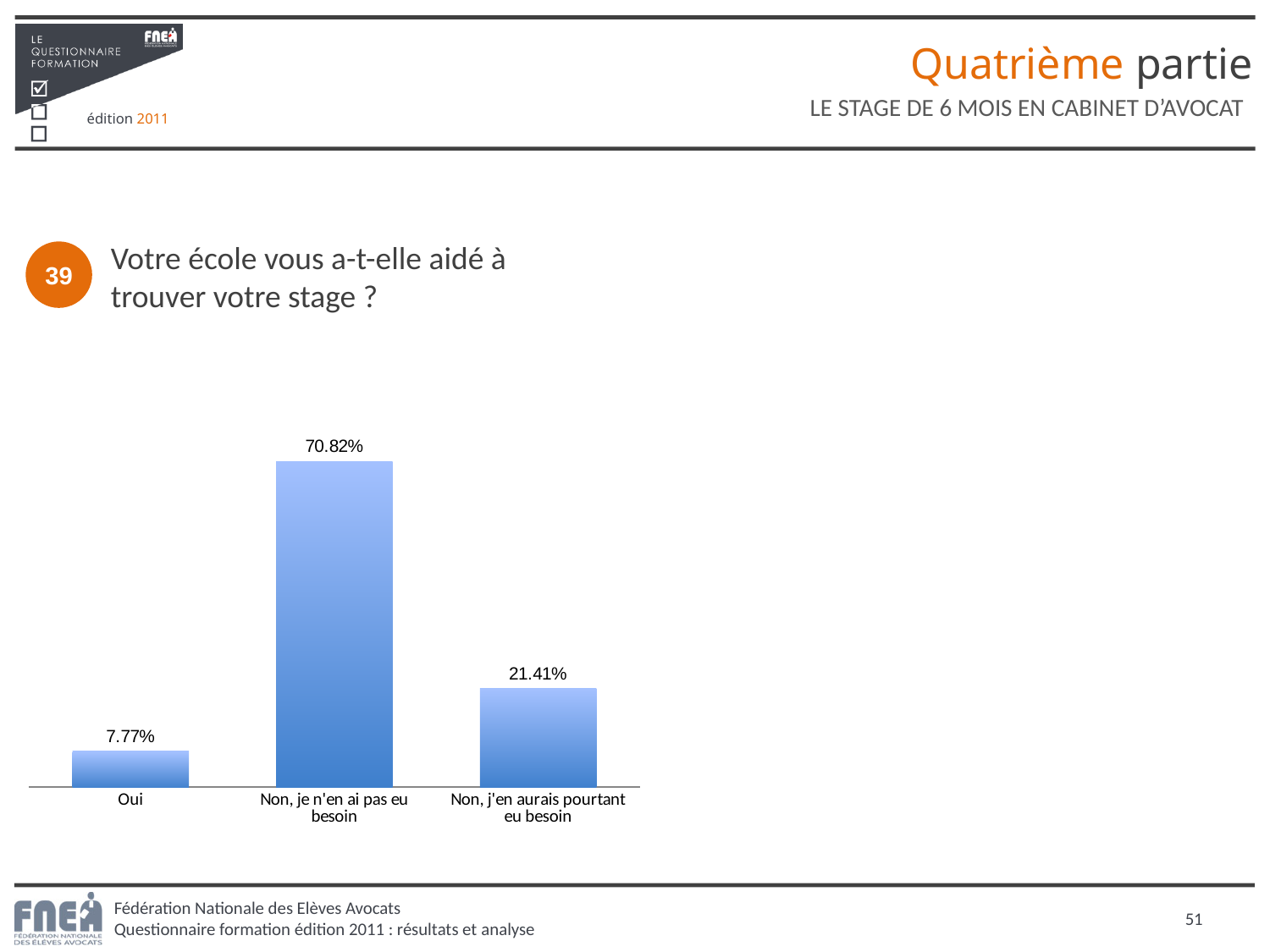
Which category has the highest value? Non, je n'en ai pas eu besoin What is the value for "Non, je n'en ai pas eu besoin"? 70.82% How many categories are shown in the chart? 3 What kind of chart is shown on the slide? Bar chart Which is larger: the value for "Oui" or the value for "Non, j'en aurais pourtant eu besoin"? Non, j'en aurais pourtant eu besoin What is the value for "Non, j'en aurais pourtant eu besoin"? 21.41% What percentage of respondents answered "Oui"? 7.77% What survey question does the chart relate to? Votre école vous a-t-elle aidé à trouver votre stage ? Which category has the lowest value? Oui What is the difference between "Non, je n'en ai pas eu besoin" and "Non, j'en aurais pourtant eu besoin"? 49.41% What is the combined value of the two "Non" categories? 92.23% What is the difference between "Non, j'en aurais pourtant eu besoin" and "Oui"? 13.64%